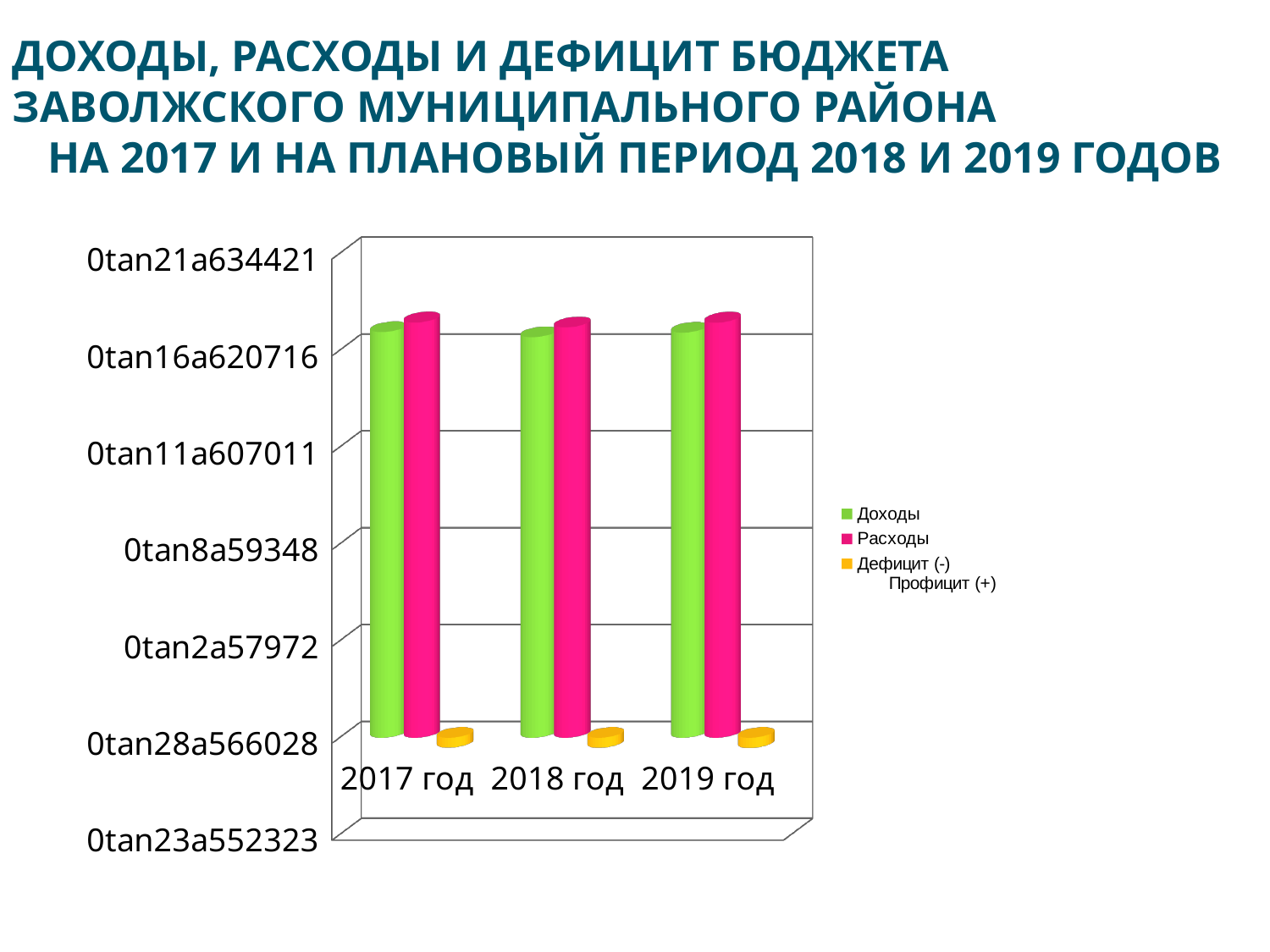
Which series is shown in yellow in the chart? Дефицит (-) Профицит (+) Which series has the lowest value for 2019 год? Дефицит (-) Профицит (+) What is the label of the last category on the x axis? 2019 год How many series does the chart legend list? 3 Which series is shown in green in the chart? Доходы How many categories (years) are shown on the x axis of the chart? 3 What is the label of the first category on the x axis? 2017 год Which series has the lowest value for 2017 год? Дефицит (-) Профицит (+) For 2017 год, which is larger: Доходы or Расходы? Расходы What kind of chart is shown on the slide? bar chart